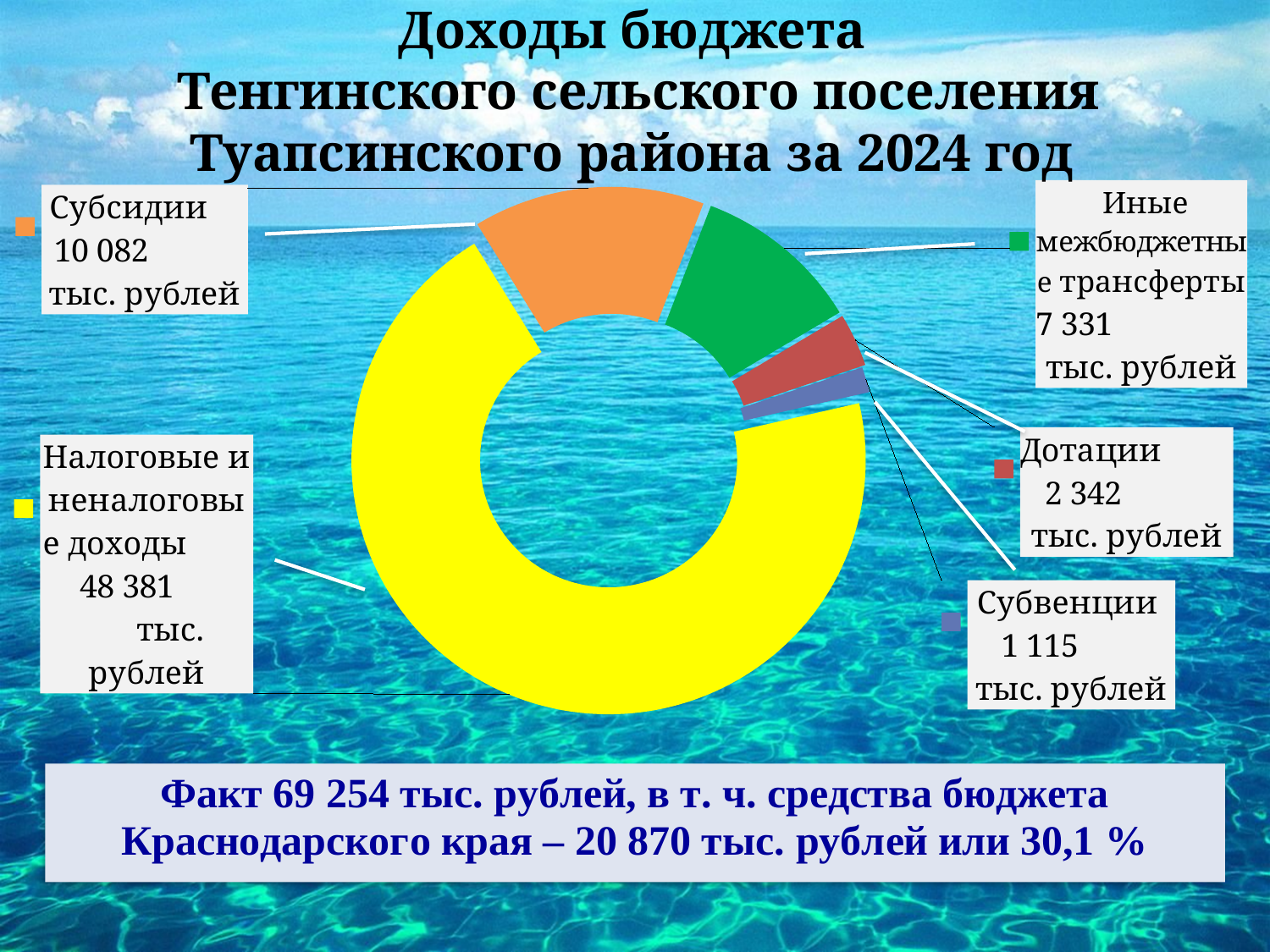
What is the value for Иные межбюджетные трансферты? 7 331 тыс. рублей What is the value for Субсидии? 10 082 тыс. рублей How many categories does the chart show? 5 What is the value for Субвенции? 1 115 тыс. рублей Which category has the largest value? Налоговые и неналоговые доходы Which category has the smallest value? Субвенции Which is larger, Дотации or Субвенции? Дотации What is the difference between Субсидии and Иные межбюджетные трансферты? 2 751 тыс. рублей What type of chart is shown on the slide? Doughnut (pie) chart What is the value for Дотации? 2 342 тыс. рублей What is the value for Налоговые и неналоговые доходы? 48 381 тыс. рублей Which colour represents Налоговые и неналоговые доходы in the chart? Yellow